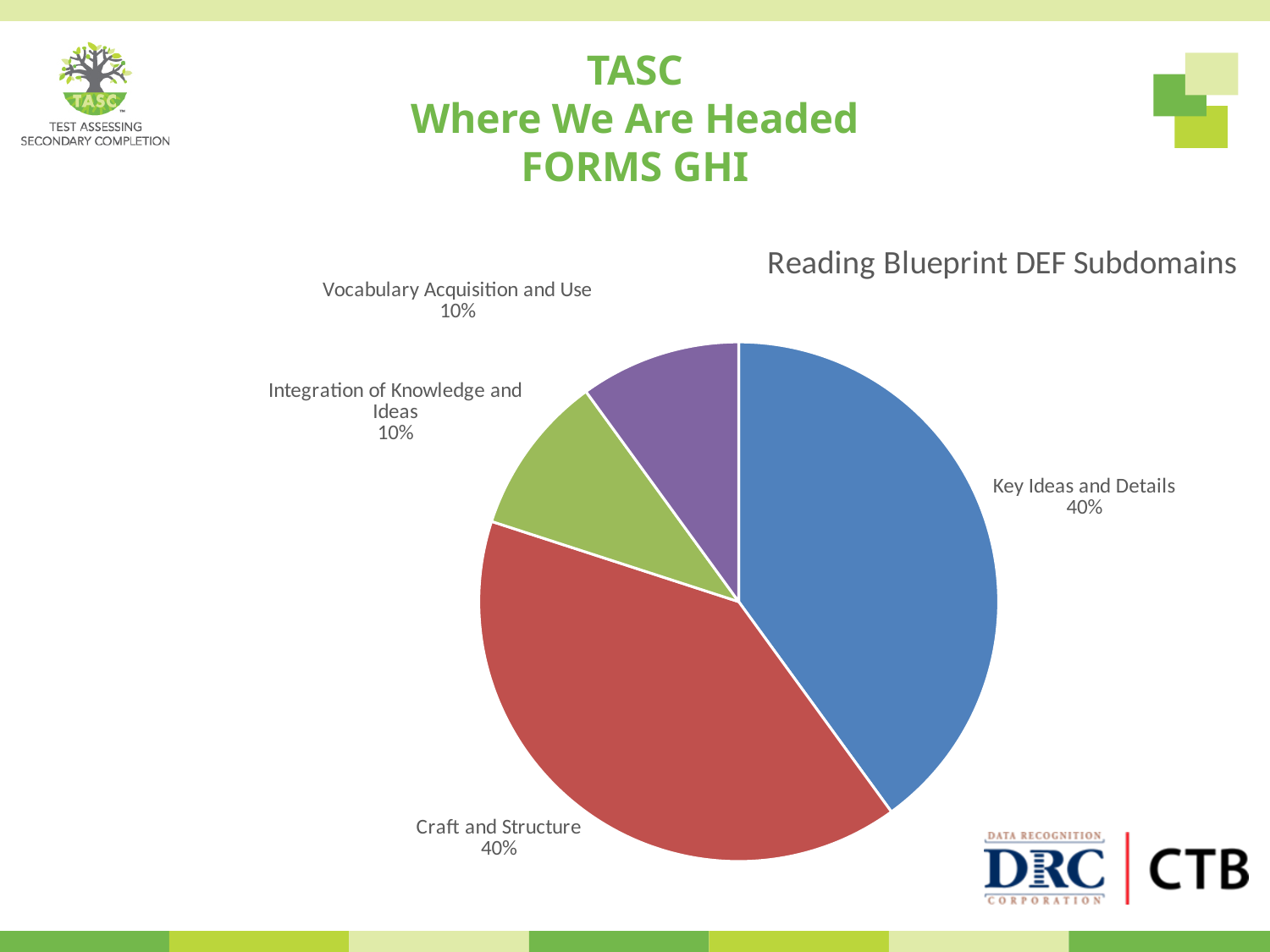
Which is larger, the Key Ideas and Details slice or the Vocabulary Acquisition and Use slice? Key Ideas and Details What percentage is shown for Integration of Knowledge and Ideas? 10% What percentage does the Craft and Structure slice represent? 40% What kind of chart is shown on the slide? Pie chart What percentage is shown for Vocabulary Acquisition and Use? 10% What colour is the Key Ideas and Details slice? Blue How many subdomains (slices) are shown in the pie chart? 4 What is the difference in percentage points between Key Ideas and Details and Integration of Knowledge and Ideas? 30 percentage points What is the title of the chart? Reading Blueprint DEF Subdomains What percentage does the Key Ideas and Details slice represent in the pie chart? 40% What share of the pie does Craft and Structure take up? 40% Which is larger, Integration of Knowledge and Ideas or Craft and Structure? Craft and Structure